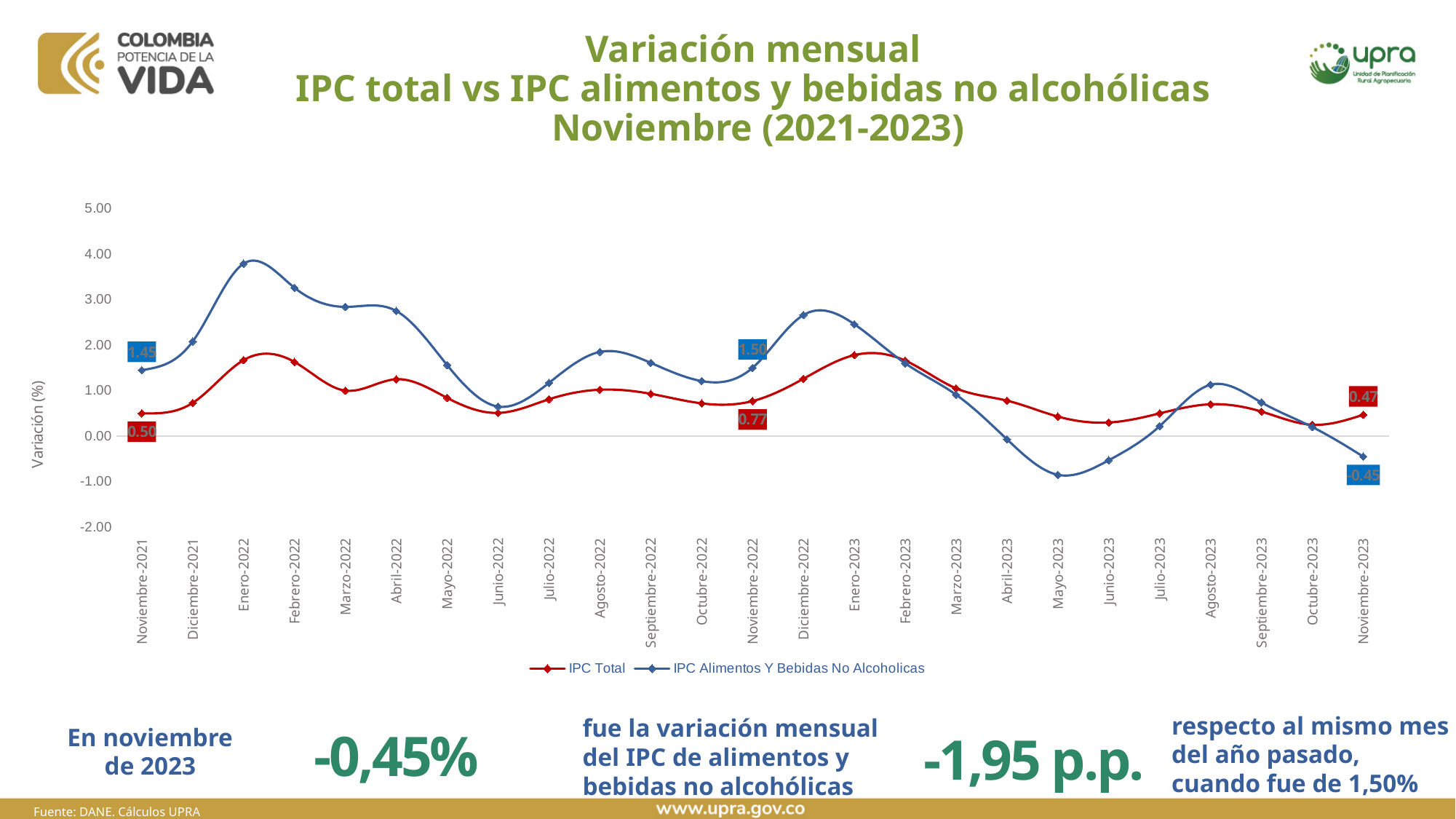
What is the value of IPC Alimentos Y Bebidas No Alcoholicas for Noviembre-2022? 1.50 How many series does the legend list? 2 In Noviembre-2022, which series has the higher value, IPC Total or IPC Alimentos Y Bebidas No Alcoholicas? IPC Alimentos Y Bebidas No Alcoholicas What is the difference between IPC Alimentos Y Bebidas No Alcoholicas in Noviembre-2022 and Noviembre-2023? 1.95 What is the value of IPC Alimentos Y Bebidas No Alcoholicas for Noviembre-2023? -0.45 What is the value of IPC Total for Noviembre-2023? 0.47 What is the label of the vertical axis? Variación (%) What is the value of IPC Total for Noviembre-2021? 0.50 What type of chart is shown on the slide? Line chart In which month does IPC Alimentos Y Bebidas No Alcoholicas reach its highest value? Enero-2022 Is the value of IPC Alimentos Y Bebidas No Alcoholicas for Enero-2022 greater or less than 3.00? greater How many months (data points) are plotted along the x axis? 25